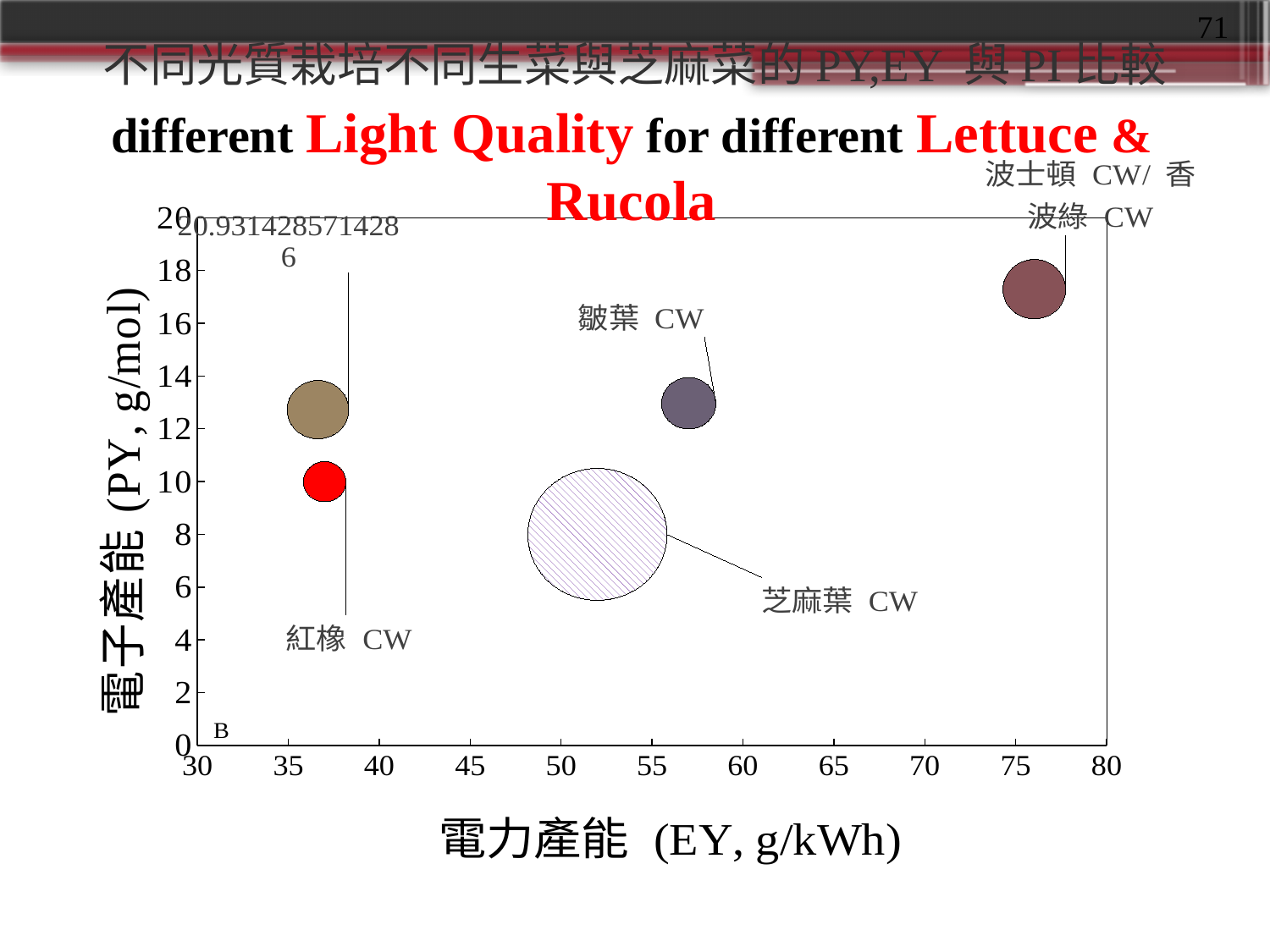
Is the 電力產能 (EY) value for 波士頓 CW/香波綠 CW greater or less than 70? greater What kind of chart is shown on the slide? bubble chart Which labeled bubble has the lowest 電子產能 (PY) value? 芝麻葉 CW Is the 電子產能 (PY) value for 芝麻葉 CW greater or less than 12? less Is the 電力產能 (EY) value for 紅橡 CW greater or less than 40? less Which labeled bubble has the lowest 電力產能 (EY) value? 紅橡 CW What is the title of the x axis? 電力產能 (EY, g/kWh) Which labeled bubble has the highest 電力產能 (EY) value? 波士頓 CW/香波綠 CW Which has the larger 電力產能 (EY) value, 皺葉 CW or 紅橡 CW? 皺葉 CW Which labeled bubble has the highest 電子產能 (PY) value? 波士頓 CW/香波綠 CW How many bubbles are plotted on the chart? 5